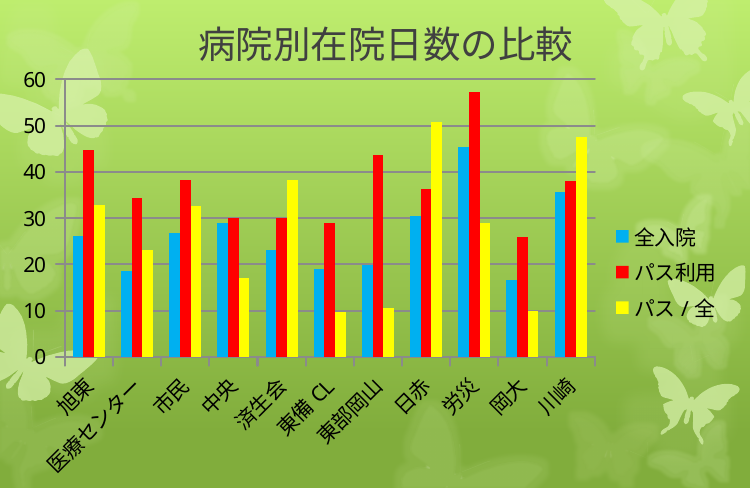
How many series does the legend list? 3 Is the パス / 全 value for 東部岡山 greater or less than 20? less Is the 全入院 value for 岡大 greater or less than 20? less What kind of chart is shown on the slide? bar chart How many hospitals (categories) are shown on the x axis? 11 Is the パス利用 value for 労災 greater or less than 50? greater Which hospital has the highest value for パス / 全? 日赤 Which is larger, the 全入院 value for 労災 or the 全入院 value for 川崎? 労災 What is the title of the chart? 病院別在院日数の比較 Which hospital has the highest value for 全入院? 労災 For 東部岡山, which is larger, the パス利用 value or the 全入院 value? パス利用 Which hospital has the highest value for パス利用? 労災